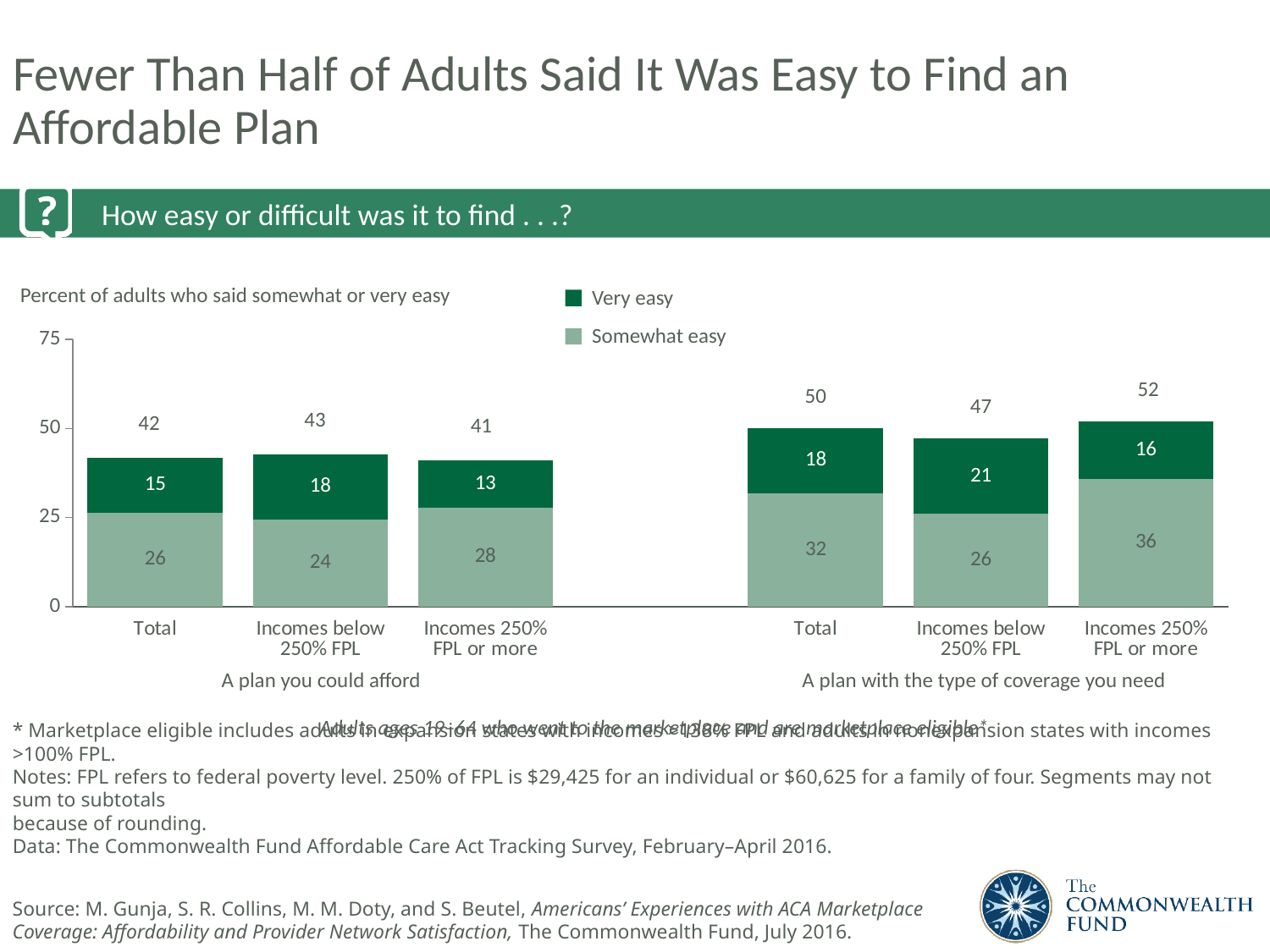
What is the combined percent (somewhat or very easy) labeled above the Total bar for 'A plan with the type of coverage you need'? 50 What is the difference between the combined percent for Total under 'A plan with the type of coverage you need' and Total under 'A plan you could afford'? 8 How many bars are plotted in the chart? 6 Which bar has the highest combined percent labeled above it? Incomes 250% FPL or more, A plan with the type of coverage you need What is the 'Somewhat easy' value for Incomes 250% FPL or more under 'A plan with the type of coverage you need'? 36 What is the 'Very easy' value for Incomes below 250% FPL under 'A plan with the type of coverage you need'? 21 Which colour represents 'Very easy' in the legend? Dark green Which is larger: the 'Somewhat easy' value for Incomes 250% FPL or more under 'A plan you could afford' or under 'A plan with the type of coverage you need'? A plan with the type of coverage you need What type of chart is shown on the slide? Stacked bar chart How many series does the legend list? 2 What is the 'Very easy' value for Total under 'A plan you could afford'? 15 Which bar has the lowest combined percent labeled above it? Incomes 250% FPL or more, A plan you could afford